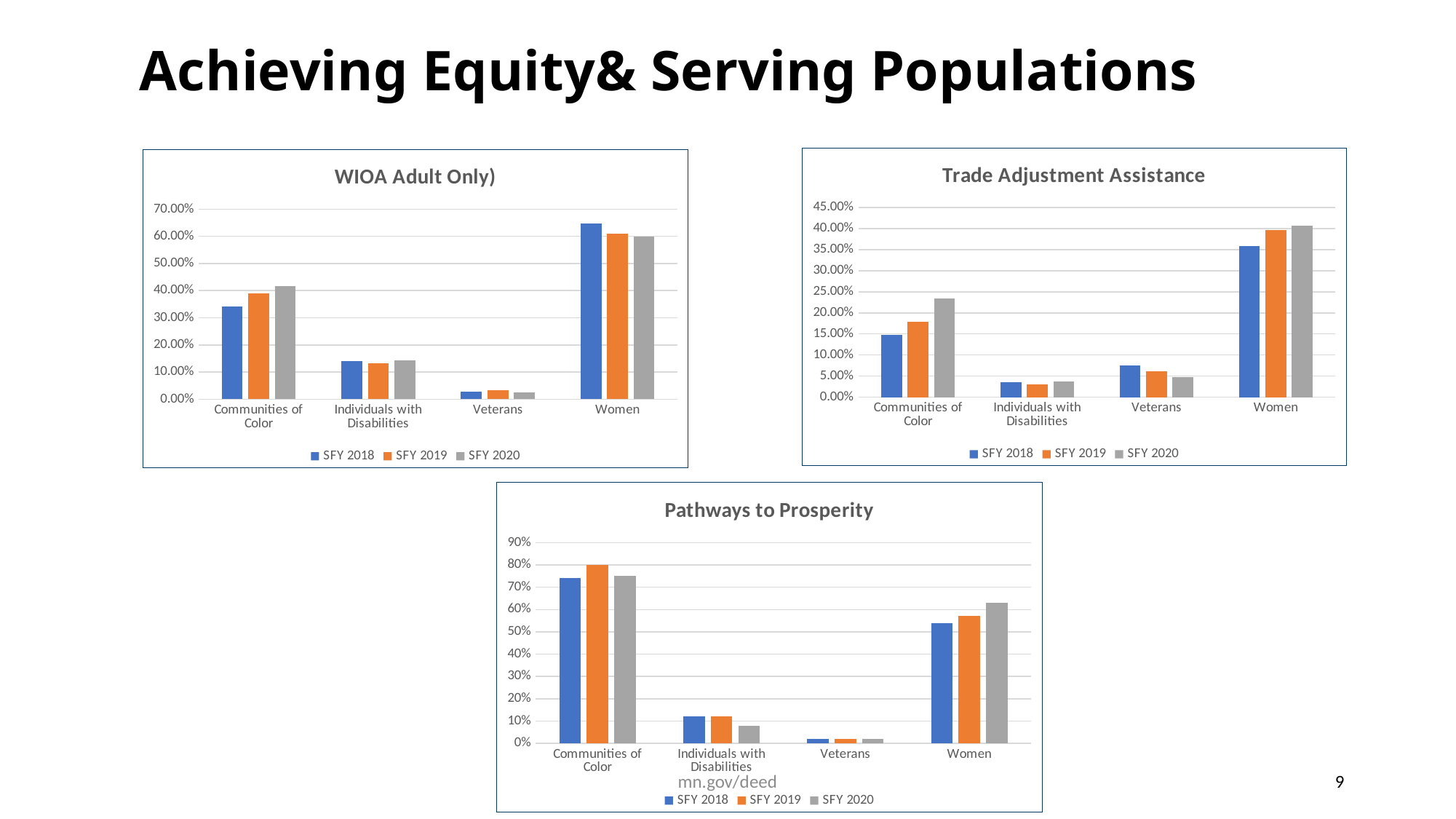
In the WIOA Adult Only) chart, which category has the lowest values? Veterans What kind of chart is the Pathways to Prosperity chart? bar chart In the WIOA Adult Only) chart, is the SFY 2018 value for Women greater or less than 60.00%? greater In the Pathways to Prosperity chart, how many series does the legend list? 3 In the Trade Adjustment Assistance chart, is the SFY 2020 value for Communities of Color greater or less than 20.00%? greater In the Pathways to Prosperity chart, is the SFY 2020 value for Women greater or less than 60%? greater In the Trade Adjustment Assistance chart, do the values for Communities of Color rise or fall from SFY 2018 to SFY 2020? rise In the Trade Adjustment Assistance chart, which category has the highest values? Women In the Trade Adjustment Assistance chart, which category has the lowest SFY 2018 value? Individuals with Disabilities In the Pathways to Prosperity chart, which category has the highest values? Communities of Color In the WIOA Adult Only) chart, which category has the highest values? Women